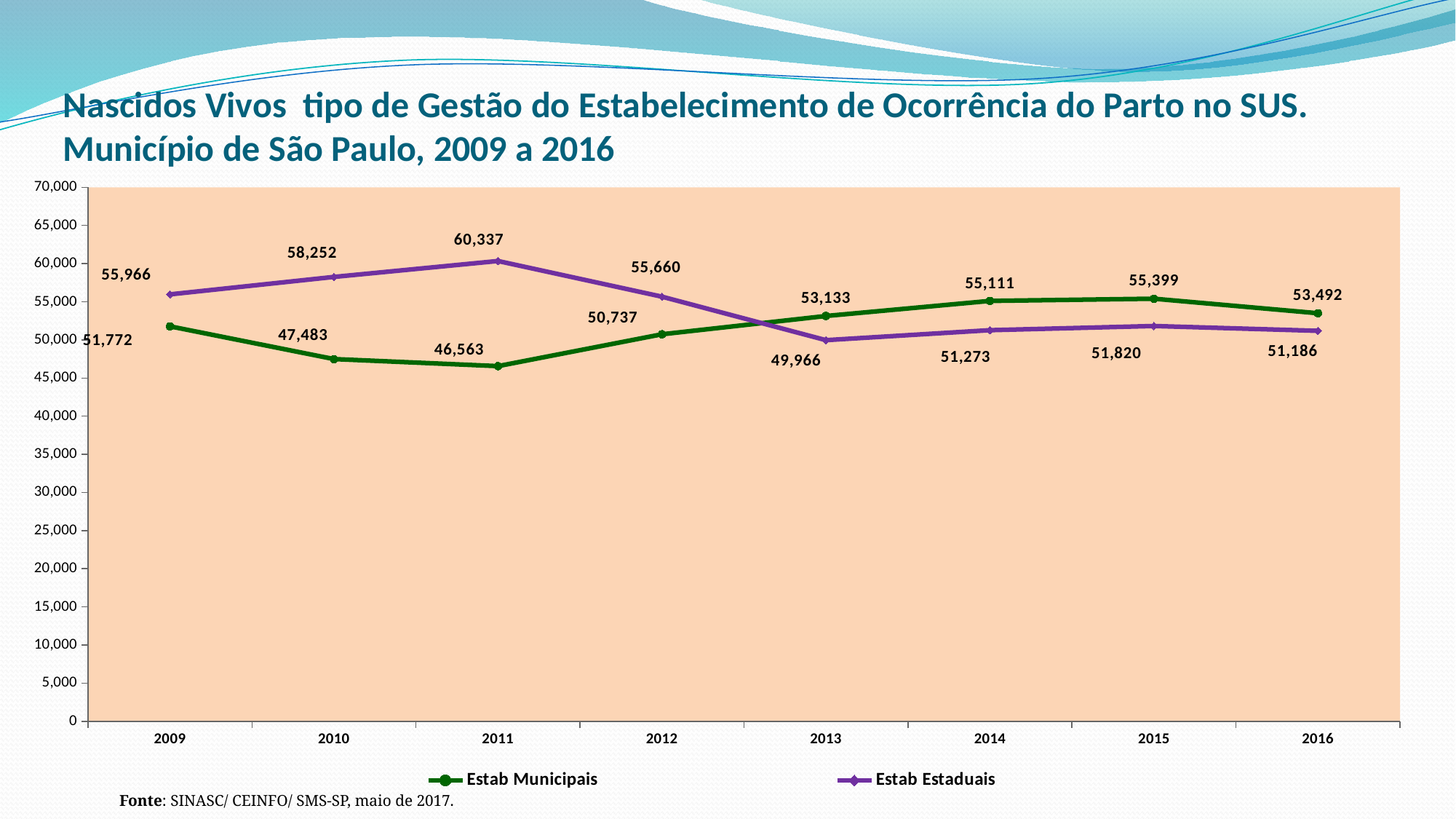
What type of chart is shown on the slide? line chart How many series does the legend list? 2 Which series has the larger value in 2015, Estab Municipais or Estab Estaduais? Estab Municipais Is the value for Estab Estaduais in 2010 greater or less than 55,000? greater In which year is the value for Estab Municipais lowest? 2011 What is the difference between Estab Estaduais and Estab Municipais in 2011? 13,774 How many years are plotted on the x axis? 8 What is the value for Estab Estaduais in 2013? 49,966 What colour is the line for Estab Municipais? green In which year is the value for Estab Estaduais highest? 2011 What is the value for Estab Municipais in 2011? 46,563 Does the Estab Estaduais line rise or fall from 2011 to 2013? fall